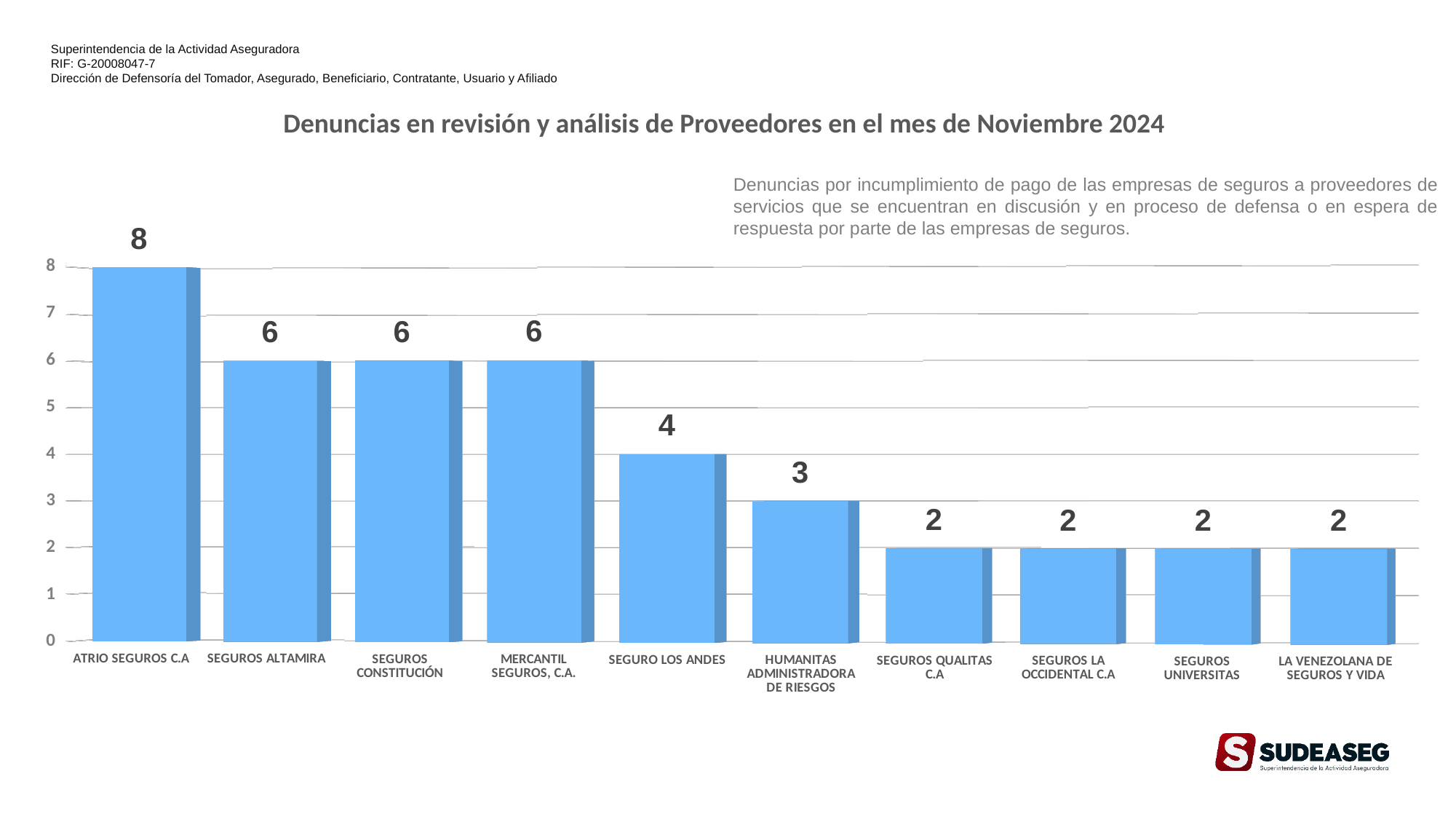
What is the value for SEGURO LOS ANDES? 4 What is the value for SEGUROS UNIVERSITAS? 2 Which category has the highest value? ATRIO SEGUROS C.A Do the values rise or fall from left to right along the x axis? fall What is the difference between the values for ATRIO SEGUROS C.A and SEGUROS ALTAMIRA? 2 Which is larger, the value for MERCANTIL SEGUROS, C.A. or the value for HUMANITAS ADMINISTRADORA DE RIESGOS? MERCANTIL SEGUROS, C.A. What is the value for HUMANITAS ADMINISTRADORA DE RIESGOS? 3 What is the title of the chart? Denuncias en revisión y análisis de Proveedores en el mes de Noviembre 2024 What kind of chart is shown on the slide? bar chart What is the difference between the values for SEGURO LOS ANDES and LA VENEZOLANA DE SEGUROS Y VIDA? 2 What is the value for ATRIO SEGUROS C.A? 8 How many categories are shown on the x axis? 10